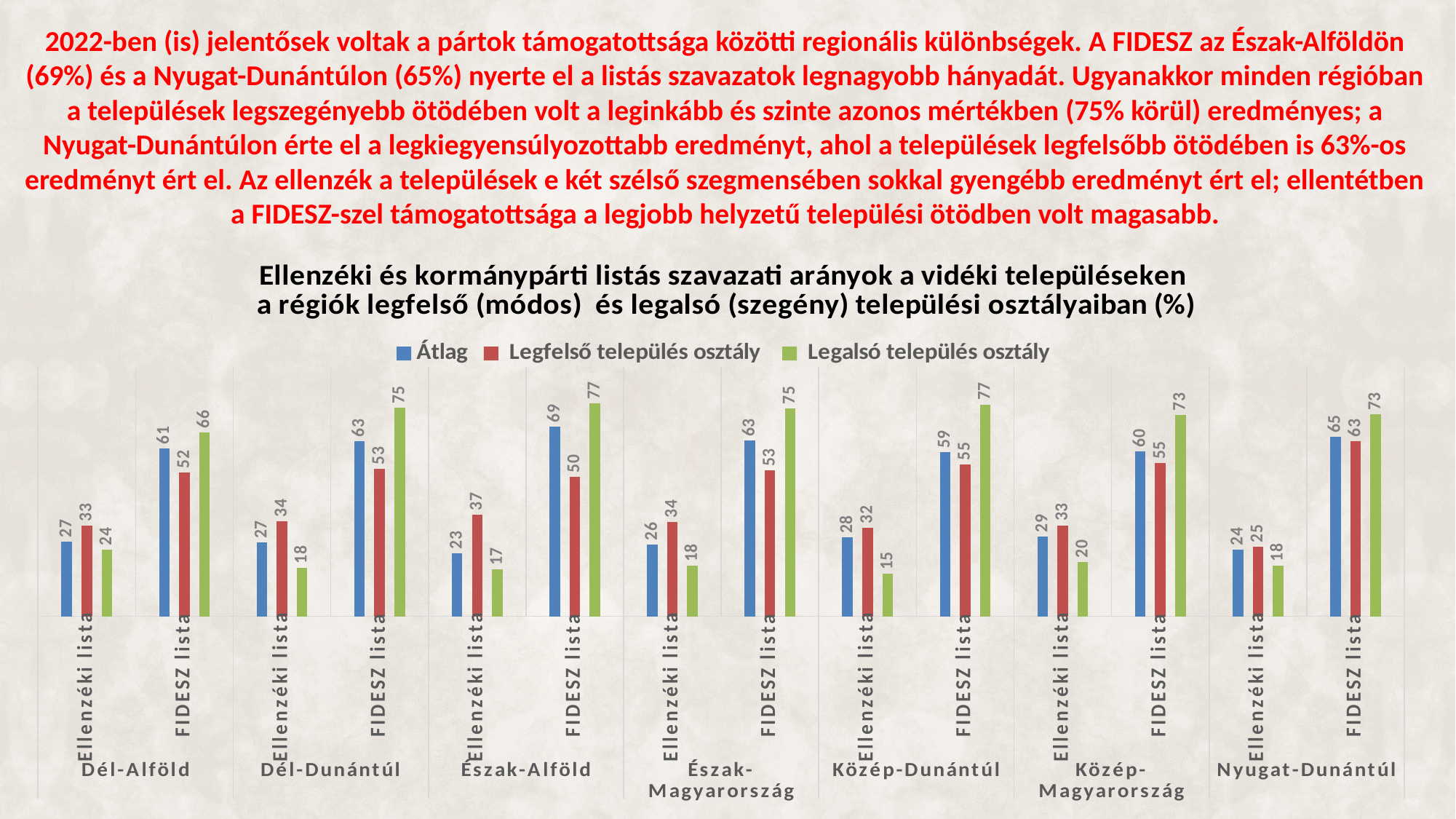
Which region has the highest Legalsó település osztály value for the Ellenzéki lista? Dél-Alföld How many regions are shown on the x axis? 7 What is the difference between the Legalsó and Legfelső település osztály values for the FIDESZ lista in Észak-Alföld? 27 What is the Átlag value for the Ellenzéki lista in Közép-Magyarország? 29 What is the Legalsó település osztály value for the Ellenzéki lista in Közép-Dunántúl? 15 What is the Legfelső település osztály value for the FIDESZ lista in Nyugat-Dunántúl? 63 Which region has the lowest Átlag value for the Ellenzéki lista? Észak-Alföld For the FIDESZ lista in Dél-Alföld, which is larger: the Átlag value or the Legfelső település osztály value? Átlag What kind of chart is shown on the slide? Bar chart How many series does the legend list? 3 What is the Átlag value for the FIDESZ lista in Észak-Alföld? 69 What colour are the bars for the Legalsó település osztály series? Green